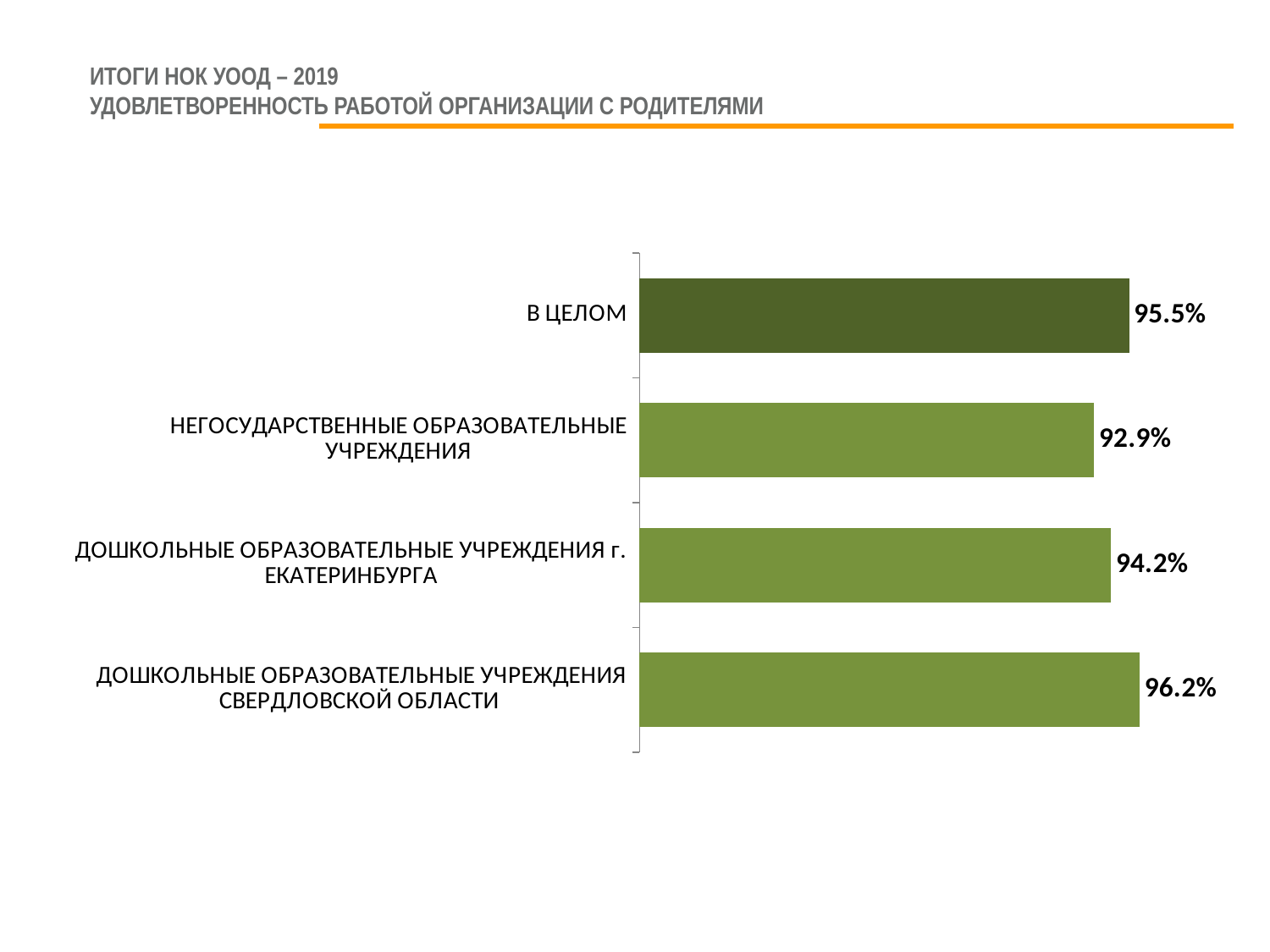
How many categories are shown in the chart? 4 What is the value for ДОШКОЛЬНЫЕ ОБРАЗОВАТЕЛЬНЫЕ УЧРЕЖДЕНИЯ г. ЕКАТЕРИНБУРГА? 94.2% What is the value for НЕГОСУДАРСТВЕННЫЕ ОБРАЗОВАТЕЛЬНЫЕ УЧРЕЖДЕНИЯ? 92.9% Which category has the lowest value? НЕГОСУДАРСТВЕННЫЕ ОБРАЗОВАТЕЛЬНЫЕ УЧРЕЖДЕНИЯ What is the difference between the values for ДОШКОЛЬНЫЕ ОБРАЗОВАТЕЛЬНЫЕ УЧРЕЖДЕНИЯ СВЕРДЛОВСКОЙ ОБЛАСТИ and НЕГОСУДАРСТВЕННЫЕ ОБРАЗОВАТЕЛЬНЫЕ УЧРЕЖДЕНИЯ? 3.3% Which category has the highest value? ДОШКОЛЬНЫЕ ОБРАЗОВАТЕЛЬНЫЕ УЧРЕЖДЕНИЯ СВЕРДЛОВСКОЙ ОБЛАСТИ What kind of chart is shown on the slide? Bar chart Which bar is drawn in a darker shade of green than the others? В ЦЕЛОМ Which is larger: the value for В ЦЕЛОМ or the value for ДОШКОЛЬНЫЕ ОБРАЗОВАТЕЛЬНЫЕ УЧРЕЖДЕНИЯ г. ЕКАТЕРИНБУРГА? В ЦЕЛОМ What is the value for В ЦЕЛОМ? 95.5% What is the difference between the values for В ЦЕЛОМ and ДОШКОЛЬНЫЕ ОБРАЗОВАТЕЛЬНЫЕ УЧРЕЖДЕНИЯ г. ЕКАТЕРИНБУРГА? 1.3% What is the value for ДОШКОЛЬНЫЕ ОБРАЗОВАТЕЛЬНЫЕ УЧРЕЖДЕНИЯ СВЕРДЛОВСКОЙ ОБЛАСТИ? 96.2%